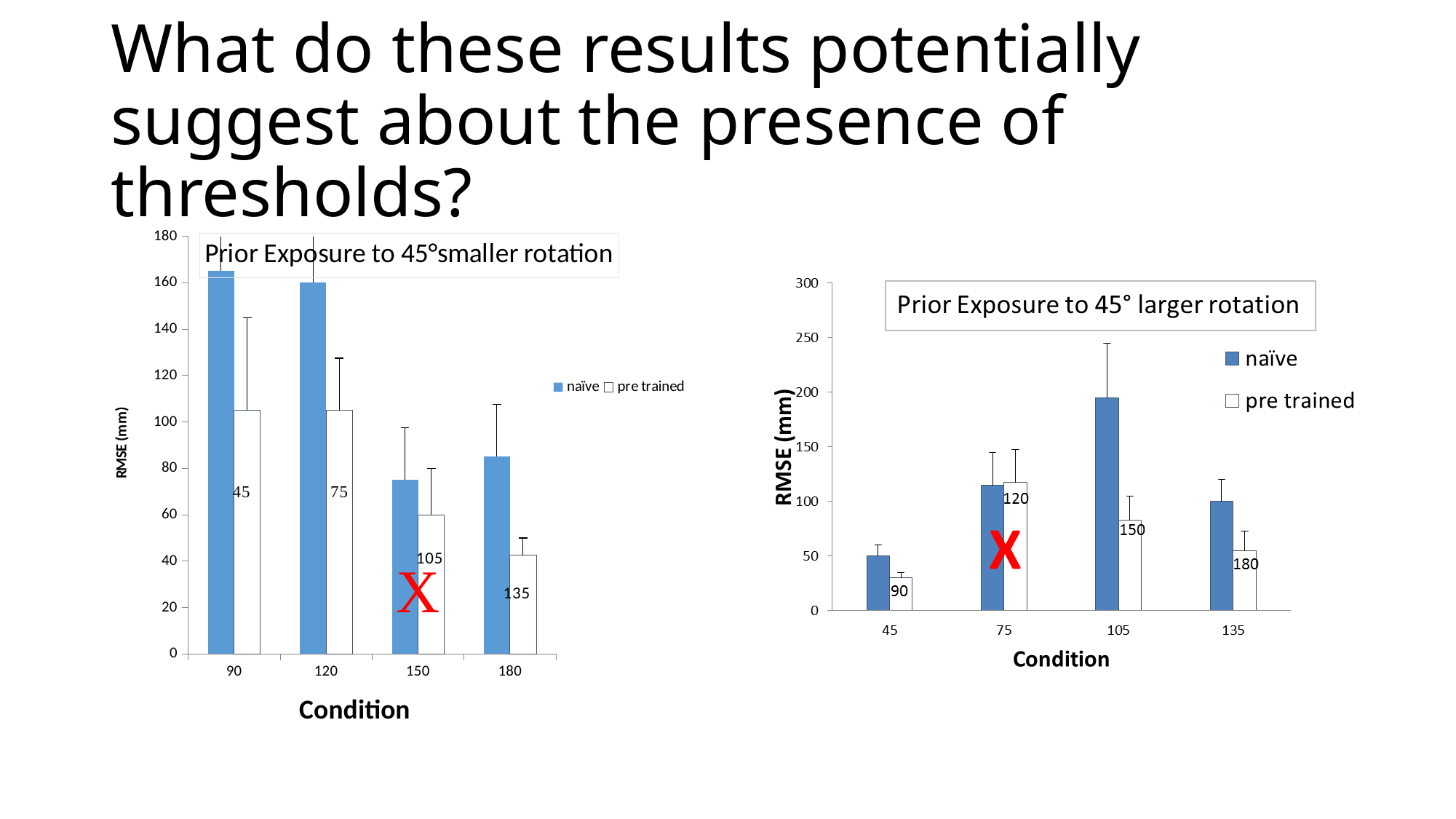
In the right chart, 'Prior Exposure to 45° larger rotation', is the naïve RMSE at condition 45 greater or less than 100? less What kind of chart is the 'Prior Exposure to 45°smaller rotation' chart on the left? bar chart In the left chart, 'Prior Exposure to 45°smaller rotation', at condition 150, which is larger: the naïve or the pre trained RMSE? naïve In the left chart, 'Prior Exposure to 45°smaller rotation', which condition has the lowest pre trained RMSE? 180 How many series does the legend of the right chart, 'Prior Exposure to 45° larger rotation', list? 2 In the right chart, 'Prior Exposure to 45° larger rotation', which condition has the highest naïve RMSE? 105 In the left chart, 'Prior Exposure to 45°smaller rotation', which condition has the highest naïve RMSE? 90 What is the y-axis label of the right chart, 'Prior Exposure to 45° larger rotation'? RMSE (mm) In the right chart, 'Prior Exposure to 45° larger rotation', at condition 105, which is larger: the naïve or the pre trained RMSE? naïve In the left chart, 'Prior Exposure to 45°smaller rotation', is the naïve RMSE at condition 90 greater or less than 160? greater In the right chart, 'Prior Exposure to 45° larger rotation', which condition has the lowest pre trained RMSE? 45 How many condition categories are shown on the x axis of the left chart, 'Prior Exposure to 45°smaller rotation'? 4